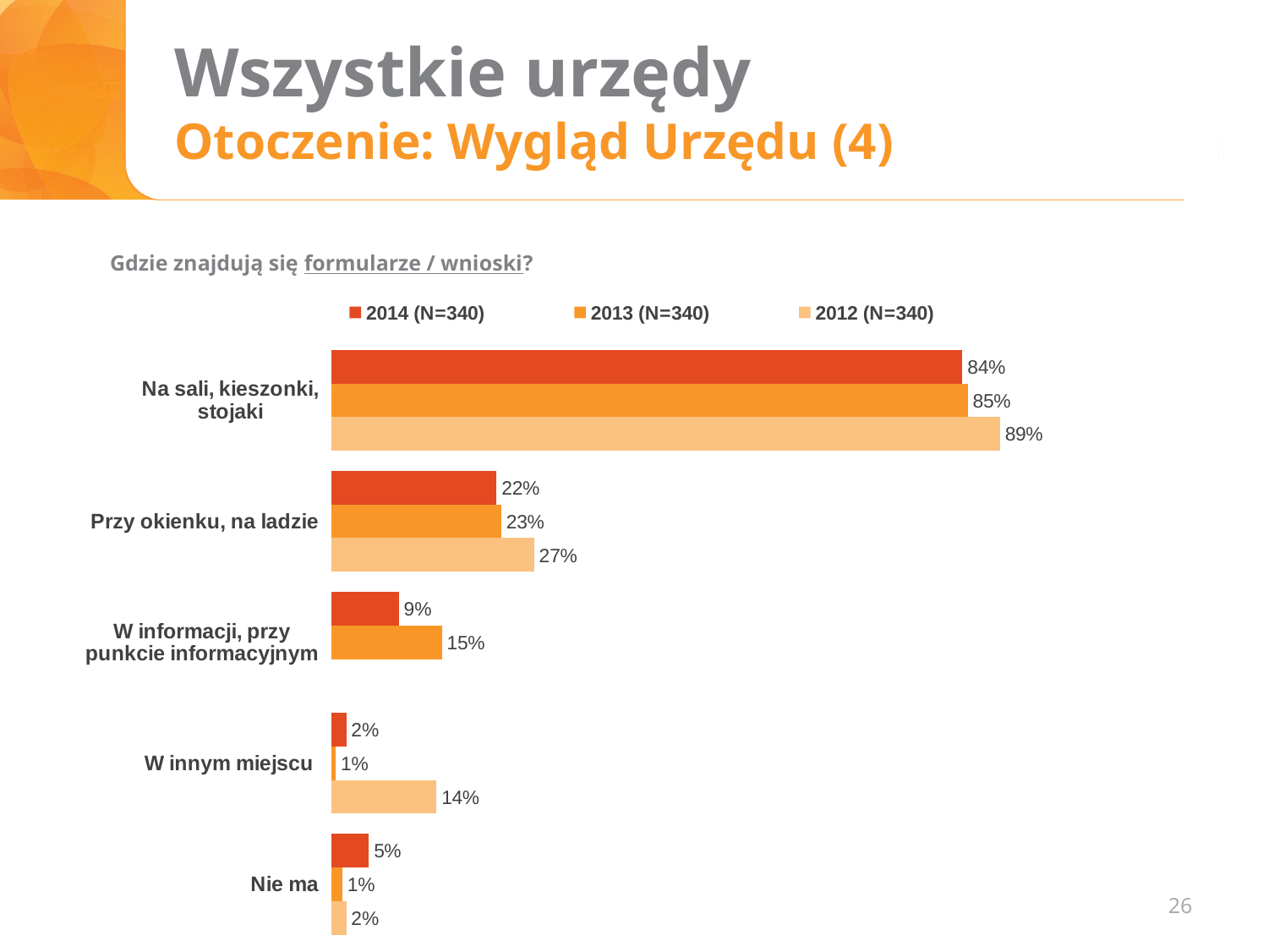
Which is larger for "Nie ma": the 2014 (N=340) value or the 2012 (N=340) value? 2014 (N=340) What is the value for "W informacji, przy punkcie informacyjnym" in the 2013 (N=340) series? 15% What is the value for "W innym miejscu" in the 2012 (N=340) series? 14% What is the difference between the 2012 (N=340) and 2014 (N=340) values for "Na sali, kieszonki, stojaki"? 5% How many categories are shown on the chart? 5 Which category has the lowest value in the 2012 (N=340) series? Nie ma What question does the chart answer, as stated above it? Gdzie znajdują się formularze / wnioski? What is the value for "Na sali, kieszonki, stojaki" in the 2014 (N=340) series? 84% How many series does the legend list? 3 Which category has the highest value in the 2014 (N=340) series? Na sali, kieszonki, stojaki What is the value for "Przy okienku, na ladzie" in the 2012 (N=340) series? 27% What kind of chart is shown on the slide? Bar chart